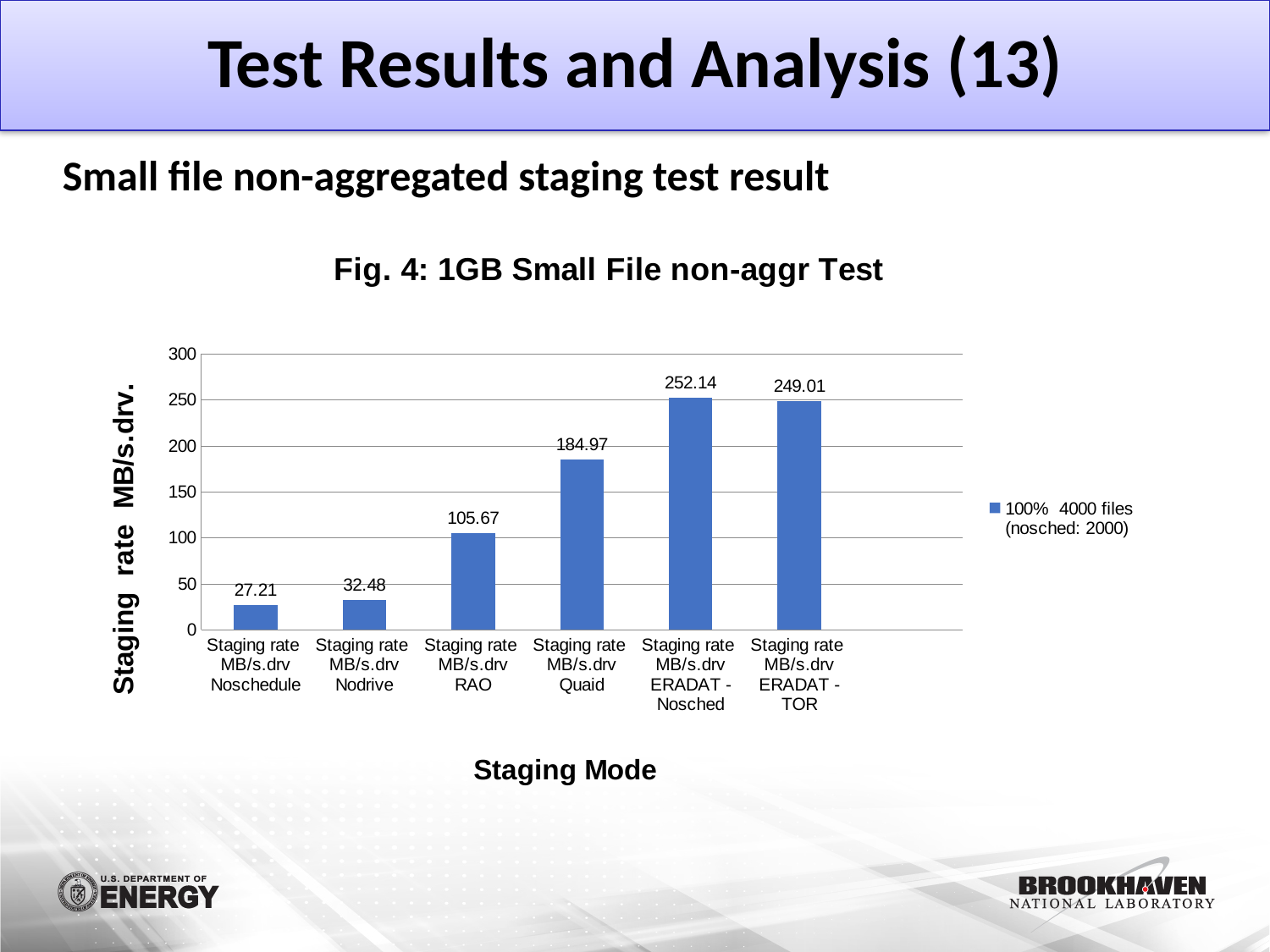
How many series does the legend list? 1 Which staging mode has the highest staging rate? ERADAT - Nosched What kind of chart is shown? bar chart Which has a higher staging rate, Nodrive or RAO? RAO What is the difference between the staging rates for Quaid and RAO? 79.3 Is the staging rate for ERADAT - TOR greater or less than 200? greater What is the staging rate for Quaid? 184.97 How many staging modes are shown in the chart? 6 What is the title of the chart? Fig. 4: 1GB Small File non-aggr Test Which staging mode has the lowest staging rate? Noschedule What is the staging rate for ERADAT - Nosched? 252.14 What is the staging rate for Noschedule? 27.21